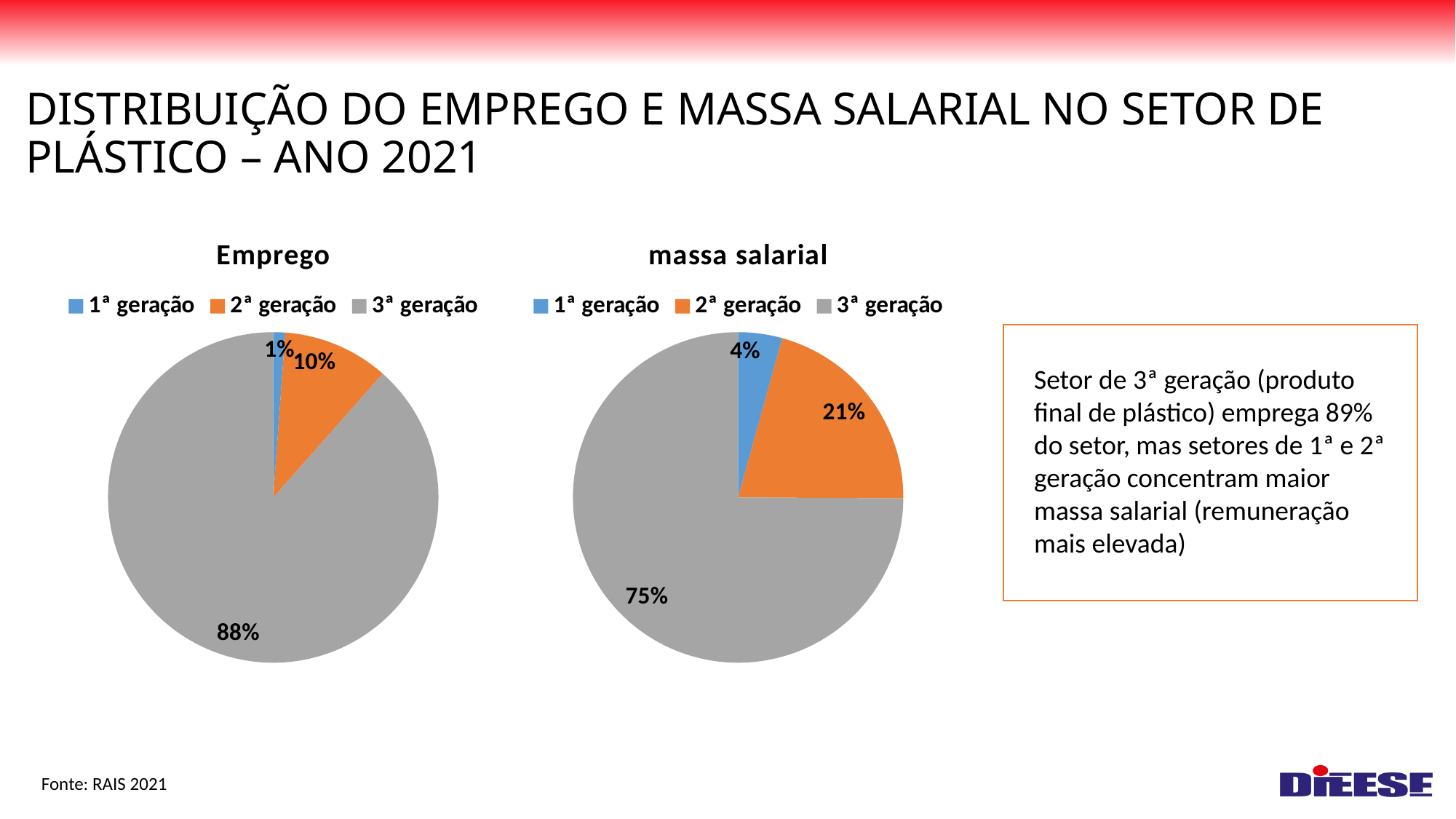
In the 'massa salarial' chart, what share does 3ª geração have? 75% What type of chart is the 'massa salarial' chart? Pie chart In the 'Emprego' chart, what share does 3ª geração have? 88% In the 'Emprego' chart, which category has the largest slice? 3ª geração In the 'massa salarial' chart, which category has the smallest slice? 1ª geração Is the 3ª geração share larger in the 'Emprego' chart or in the 'massa salarial' chart? Emprego In the 'massa salarial' chart, what share does 1ª geração have? 4% In the 'Emprego' chart, what share does 2ª geração have? 10% How many categories does the 'Emprego' chart show? 3 In the 'Emprego' chart, what share does 1ª geração have? 1% In the 'massa salarial' chart, what share does 2ª geração have? 21% What is the difference between the 2ª geração share in the 'massa salarial' chart and the 2ª geração share in the 'Emprego' chart? 11 percentage points